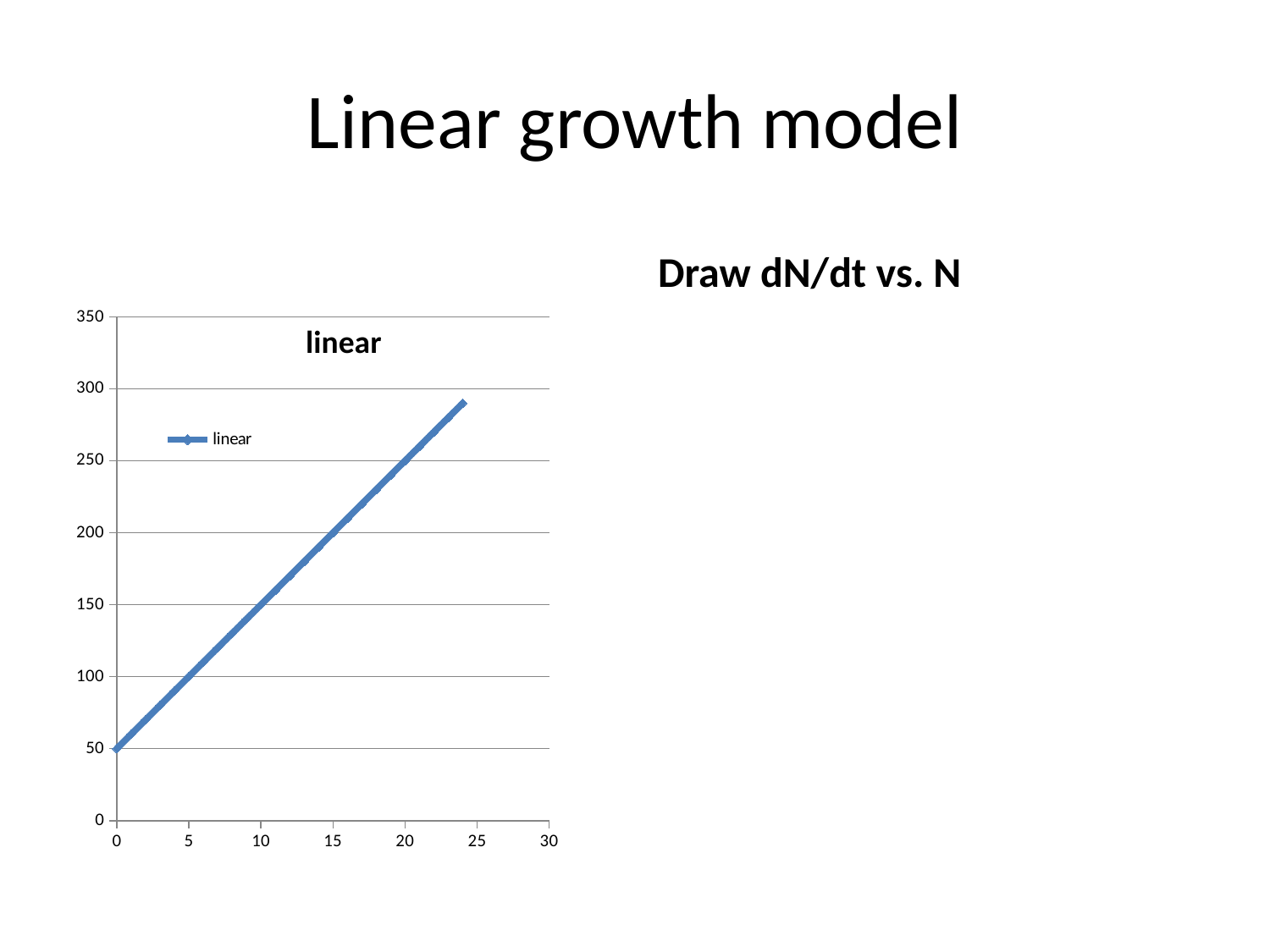
What is the title of the chart? linear Is the value of the 'linear' series at x = 24 greater or less than 250? greater What is the value of the 'linear' series at x = 10? 150 How many series does the chart legend list? 1 What is the name of the series shown in the legend? linear Is the value of the 'linear' series at x = 15 greater or less than 150? greater Which is larger for the 'linear' series: the value at x = 0 or the value at x = 20? x = 20 What is the value of the 'linear' series at x = 20? 250 Is the value of the 'linear' series at x = 5 greater or less than 150? less Do the values of the 'linear' series rise or fall as x increases? rise What is the value of the 'linear' series at x = 0? 50 What kind of chart is shown on the slide? line chart